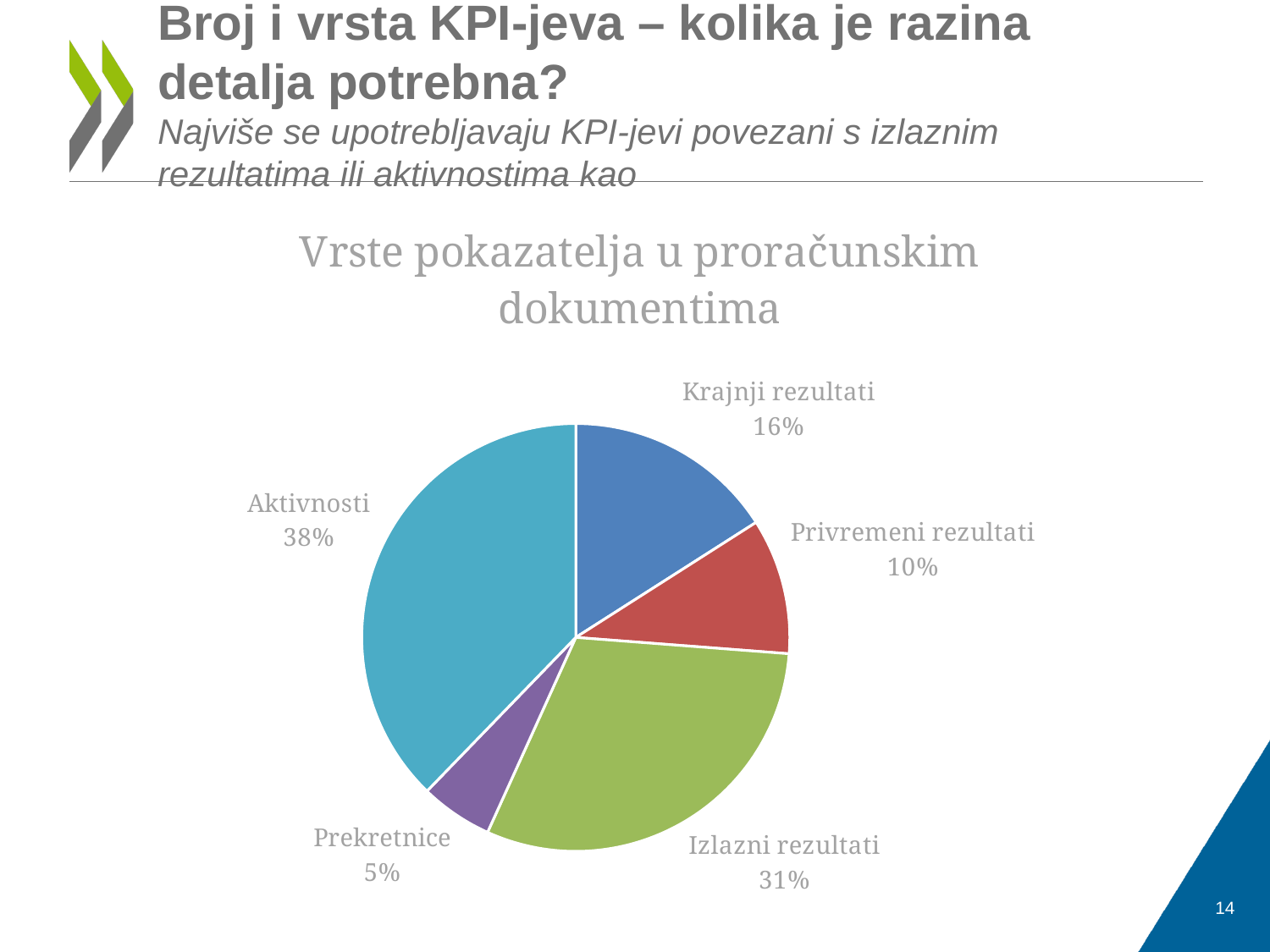
What is the difference between the shares of Aktivnosti and Izlazni rezultati? 7% What type of chart is shown on the slide? pie chart What share of the pie does Aktivnosti represent? 38% Which category has the smallest slice of the pie? Prekretnice What is the title of the chart? Vrste pokazatelja u proračunskim dokumentima Which category has the largest slice of the pie? Aktivnosti How many categories are shown in the pie chart? 5 What is the value shown for Izlazni rezultati? 31% What is the value shown for Krajnji rezultati? 16% What is the value shown for Prekretnice? 5% What is the value shown for Privremeni rezultati? 10% Which is larger, the share for Krajnji rezultati or the share for Privremeni rezultati? Krajnji rezultati